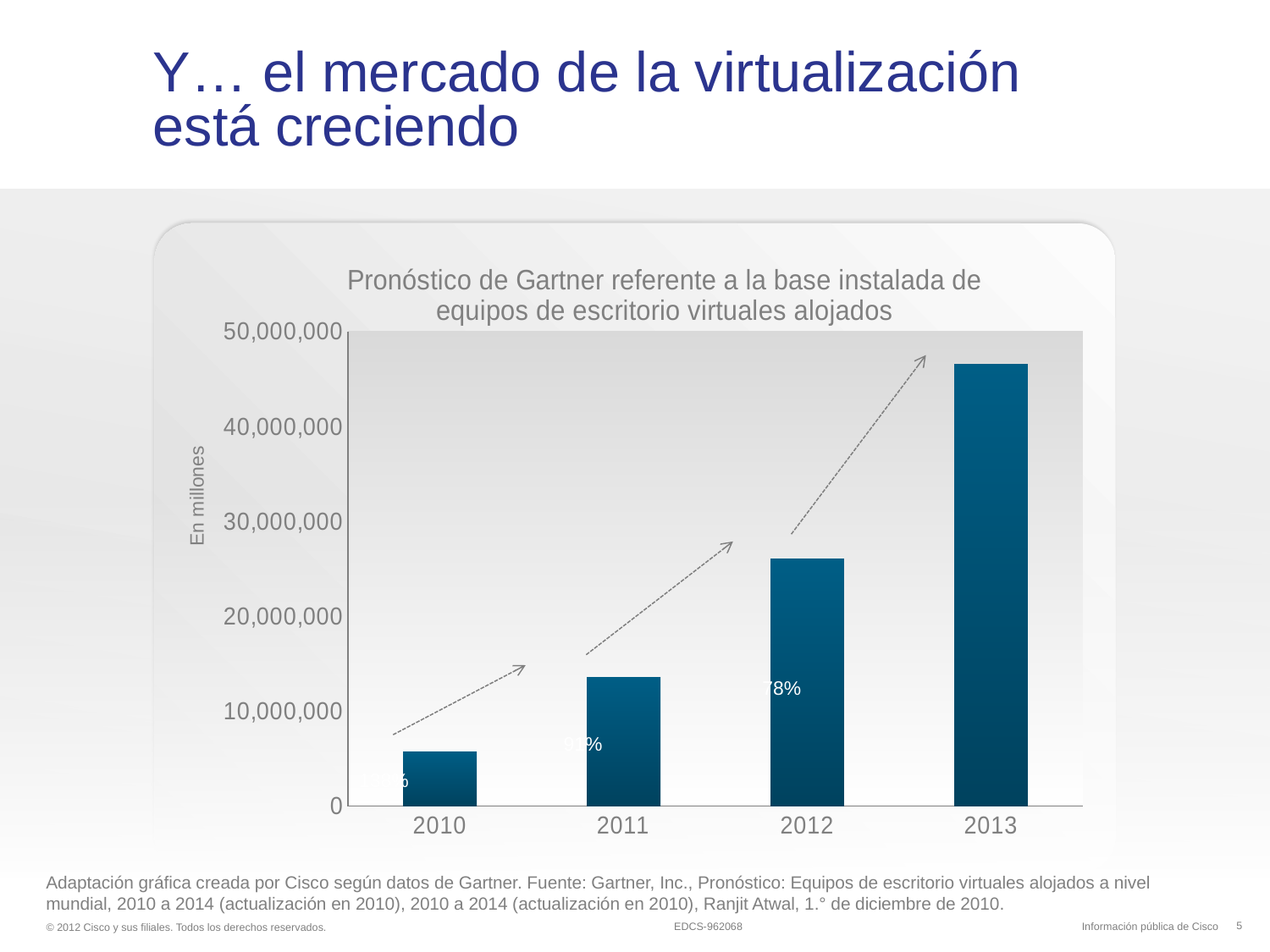
Is the value for 2011 greater or less than 10,000,000? greater How many years are shown on the x axis of the chart? 4 Do the values rise or fall from 2010 to 2013? rise What percentage label is printed on the 2012 bar? 78% Which year has the highest value in the chart? 2013 Is the value for 2013 greater or less than 40,000,000? greater Is the value for 2010 greater or less than 10,000,000? less What type of chart is shown on the slide? bar chart What is the label on the vertical axis of the chart? En millones Which year has the lowest value in the chart? 2010 Which is larger, the value for 2011 or the value for 2012? 2012